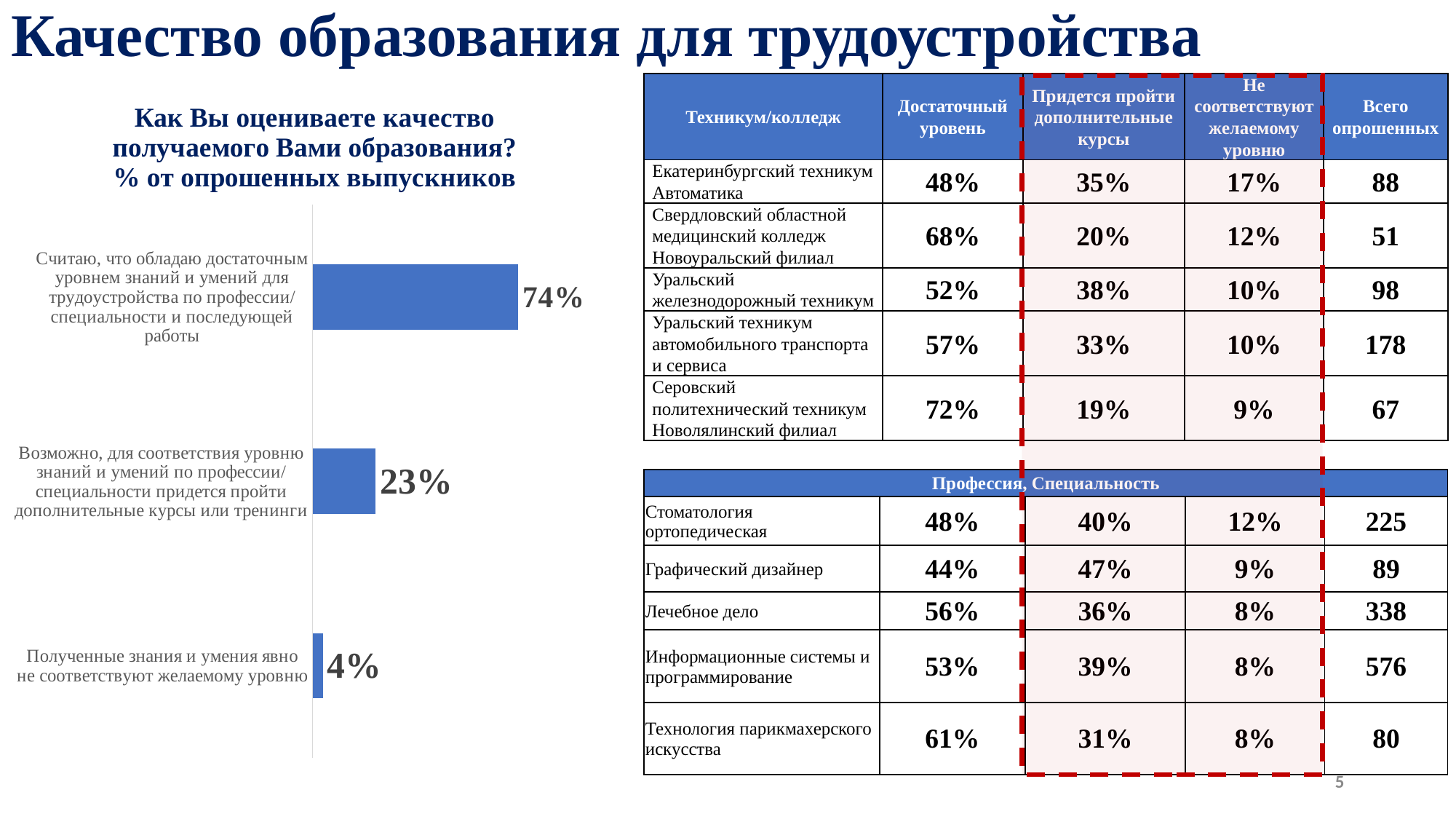
What is the value for the category "Считаю, что обладаю достаточным уровнем знаний и умений для трудоустройства по профессии/специальности и последующей работы"? 74% What is the difference between the value for "Возможно... придется пройти дополнительные курсы или тренинги" and the value for "Полученные знания и умения явно не соответствуют желаемому уровню"? 19% How many categories (bars) does the chart show? 3 What is the value for the category "Полученные знания и умения явно не соответствуют желаемому уровню"? 4% What type of chart is shown on the left of the slide? bar chart Which category has the lowest value in the chart? Полученные знания и умения явно не соответствуют желаемому уровню Which category has the highest value in the chart? Считаю, что обладаю достаточным уровнем знаний и умений для трудоустройства по профессии/специальности и последующей работы What colour are the bars in the chart? blue What is the title of the chart on the left of the slide? Как Вы оцениваете качество получаемого Вами образования? % от опрошенных выпускников What is the value for the category "Возможно, для соответствия уровню знаний и умений по профессии/специальности придется пройти дополнительные курсы или тренинги"? 23% Which is larger: the value for "Возможно... придется пройти дополнительные курсы или тренинги" or the value for "Полученные знания и умения явно не соответствуют желаемому уровню"? Возможно... придется пройти дополнительные курсы или тренинги What is the difference between the value for "Считаю, что обладаю достаточным уровнем..." (74%) and the value for "Возможно... придется пройти дополнительные курсы или тренинги" (23%)? 51%